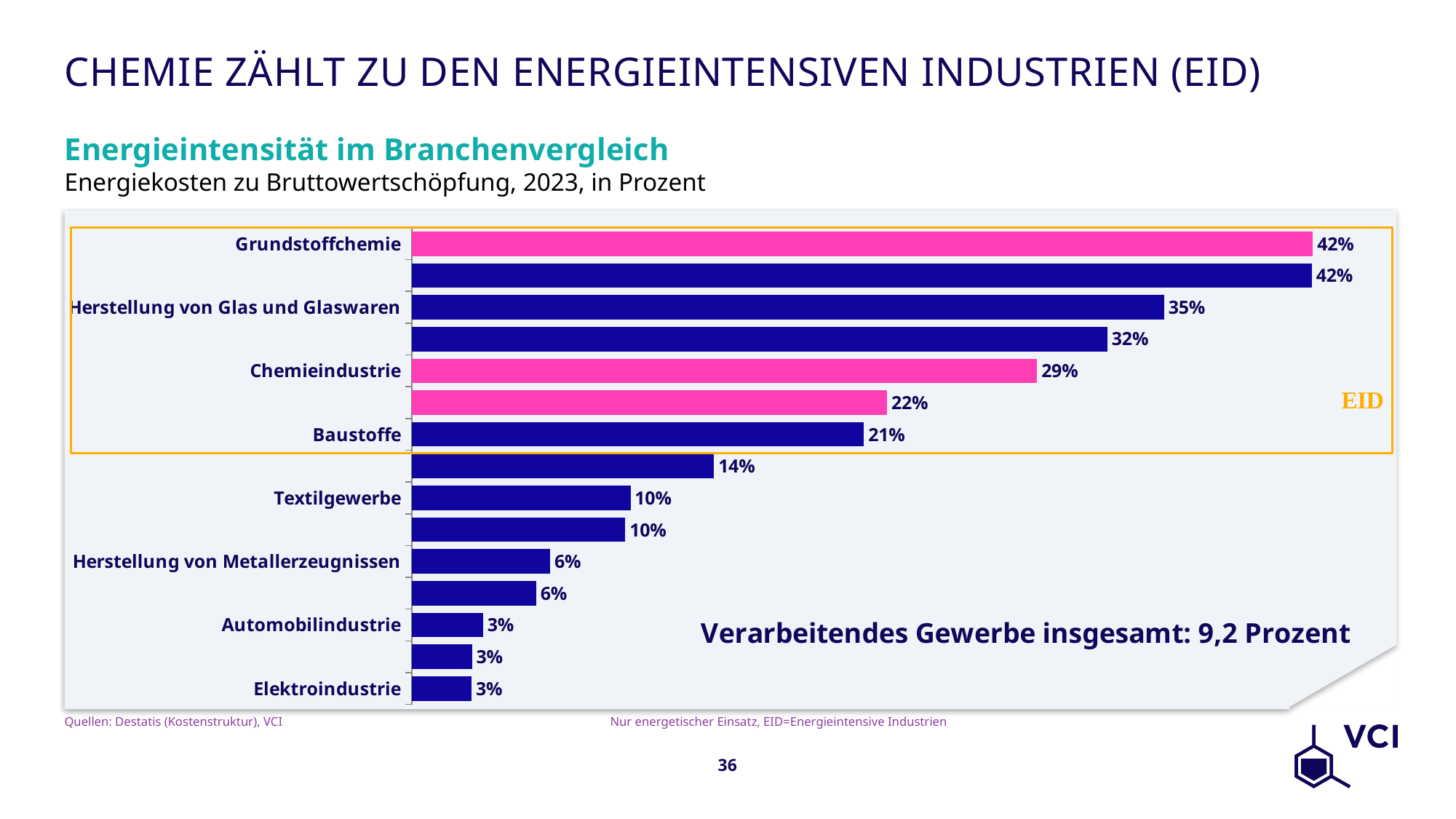
What is the value for Herstellung von Metallerzeugnissen? 6% What value is given for Verarbeitendes Gewerbe insgesamt in the chart annotation? 9,2 Prozent How many bars are plotted in the chart? 15 What is the value for Chemieindustrie? 29% Which has the larger value, Chemieindustrie or Textilgewerbe? Chemieindustrie What is the value for Grundstoffchemie? 42% What is the difference in percentage points between Grundstoffchemie and Chemieindustrie? 13 What kind of chart is shown on the slide? Bar chart What is the value for Textilgewerbe? 10% What is the title of the chart? Energieintensität im Branchenvergleich What is the value for Herstellung von Glas und Glaswaren? 35% What is the value for Baustoffe? 21%